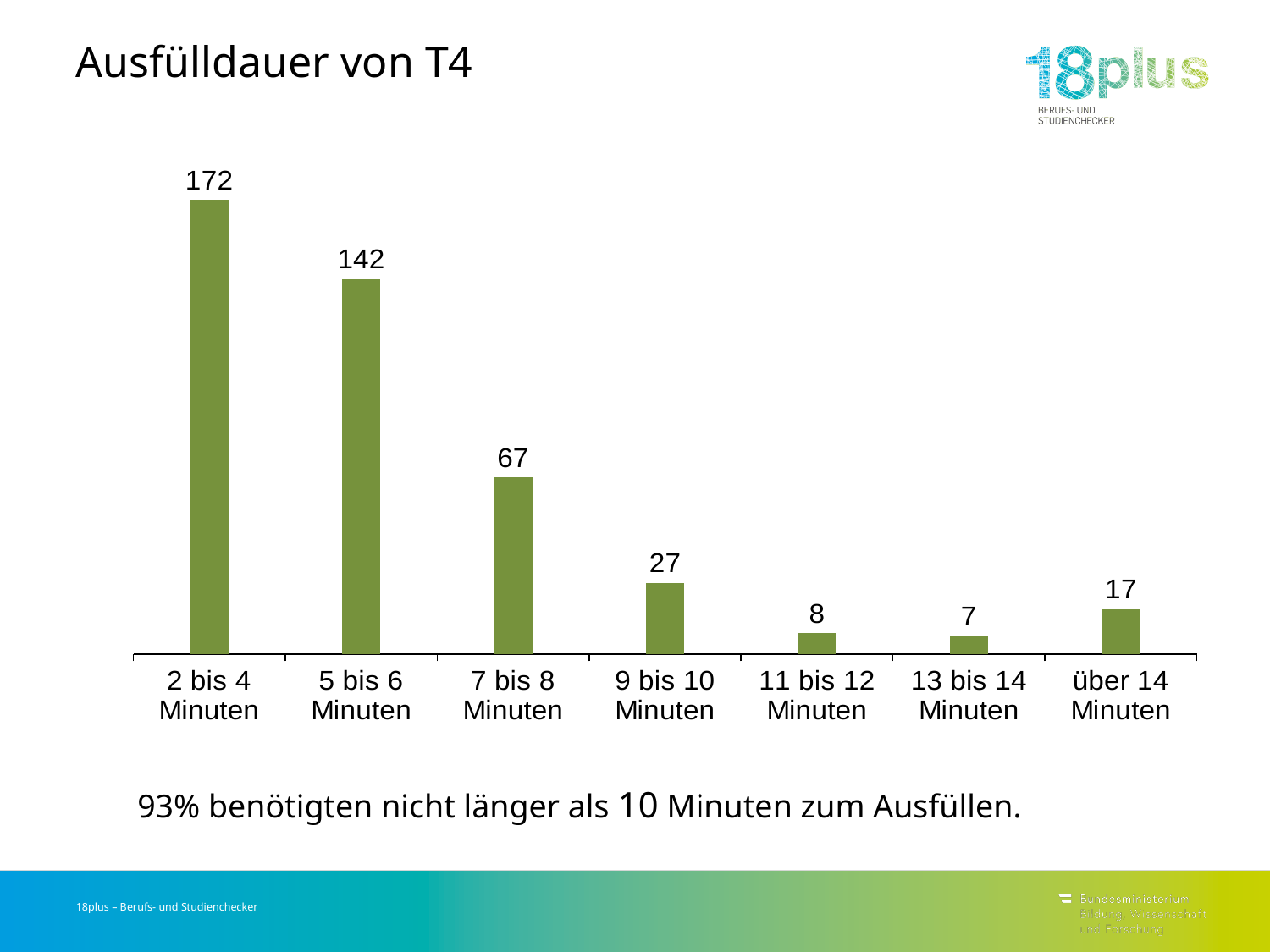
Which category has the lowest value? 13 bis 14 Minuten Do the values generally rise or fall from "2 bis 4 Minuten" to "13 bis 14 Minuten"? fall How many categories are shown on the x axis? 7 What is the value for the category "über 14 Minuten"? 17 What is the difference between the values for "7 bis 8 Minuten" and "9 bis 10 Minuten"? 40 Which is larger, the value for "11 bis 12 Minuten" or the value for "über 14 Minuten"? über 14 Minuten What is the title of the chart on the slide? Ausfülldauer von T4 What kind of chart is shown on the slide? bar chart Which category has the highest value? 2 bis 4 Minuten What is the value for the category "2 bis 4 Minuten"? 172 What is the difference between the values for "2 bis 4 Minuten" and "5 bis 6 Minuten"? 30 What is the value for the category "9 bis 10 Minuten"? 27